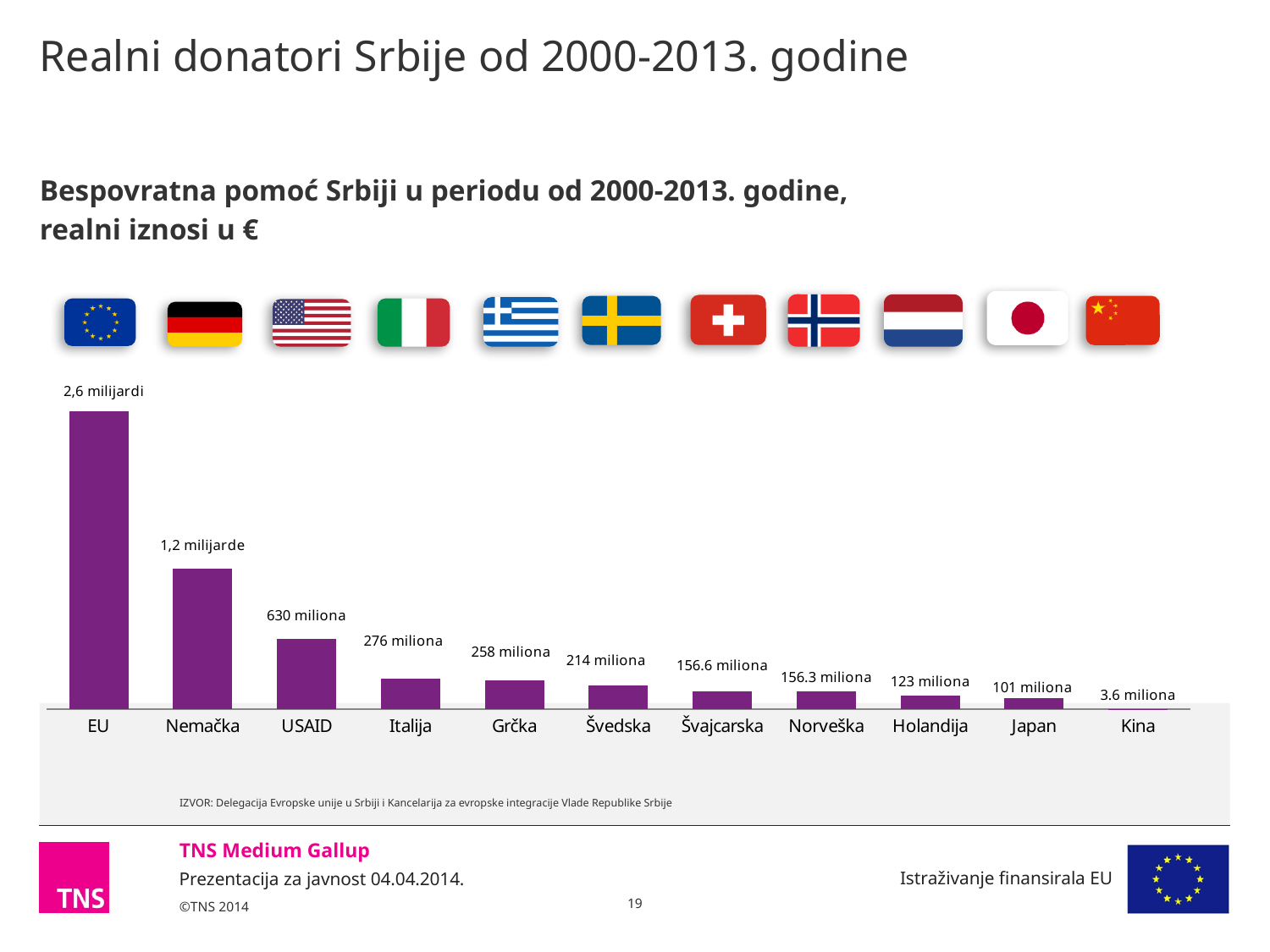
Which has a larger value, USAID or Italija? USAID Do the values rise or fall from left to right across the chart? Fall What is the value shown for EU? 2,6 milijardi What is the difference between the values for Italija and Grčka? 18 miliona What is the value shown for Kina? 3.6 miliona What is the value shown for USAID? 630 miliona What is the value shown for Nemačka? 1,2 milijarde What is the value shown for Švedska? 214 miliona How many donors are shown in the chart? 11 Which donor has the lowest value in the chart? Kina What kind of chart is shown on the slide? Bar chart Which donor has the highest value in the chart? EU